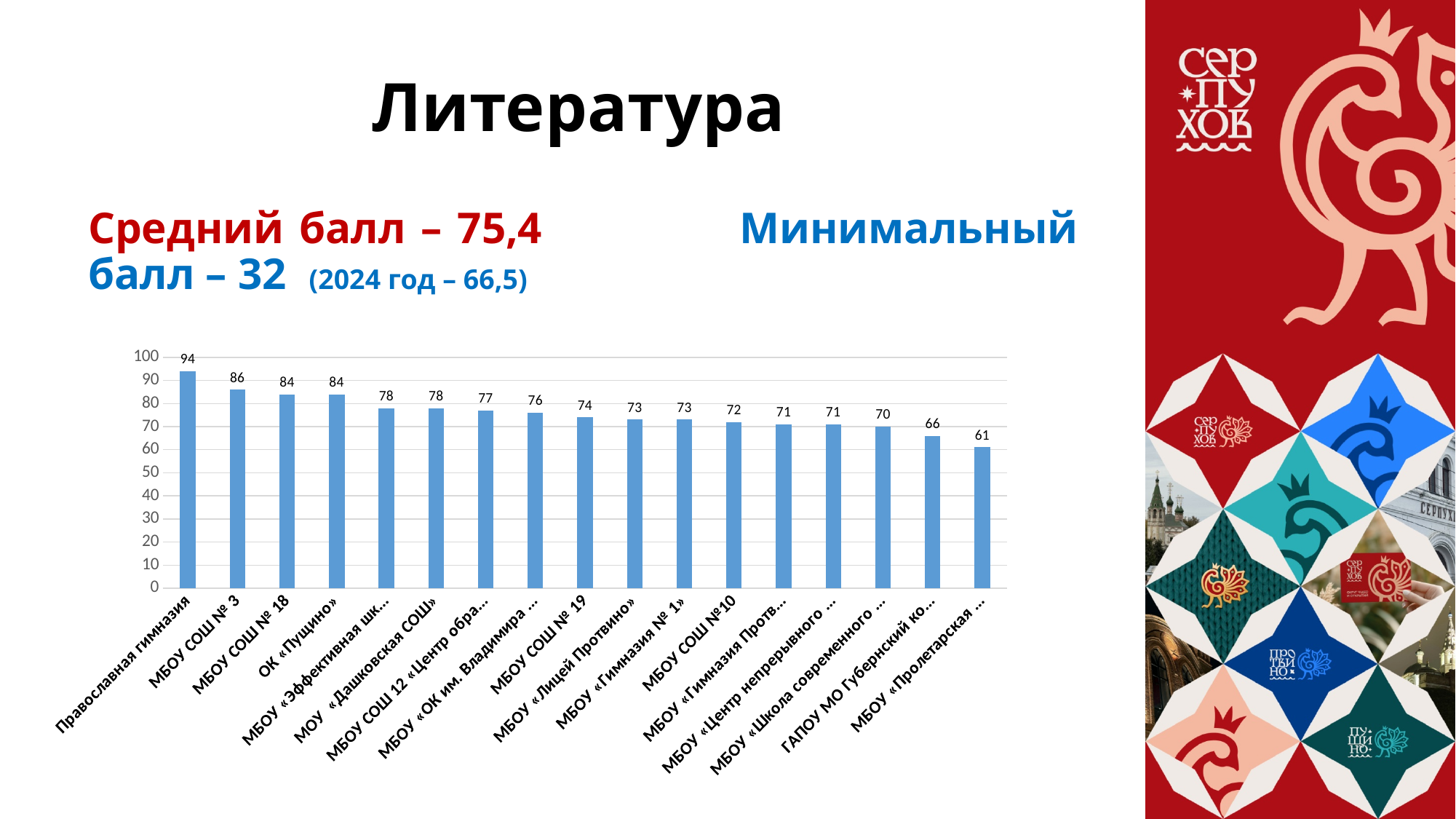
What is the difference between the values for Православная гимназия and МБОУ СОШ № 3? 8 What value is shown for МБОУ СОШ №10? 72 What kind of chart is shown on the slide? Bar chart How many bars are shown on the chart? 17 What value is shown for ОК «Пущино»? 84 What value is shown for МБОУ СОШ № 3? 86 What value is shown for МБОУ «Лицей Протвино»? 73 Which category has the highest value? Православная гимназия What is the lowest value shown on the chart? 61 What value is shown for Православная гимназия? 94 Which has a larger value, МОУ «Дашковская СОШ» or МБОУ СОШ № 19? МОУ «Дашковская СОШ» Do the values rise or fall from left to right along the x axis? Fall